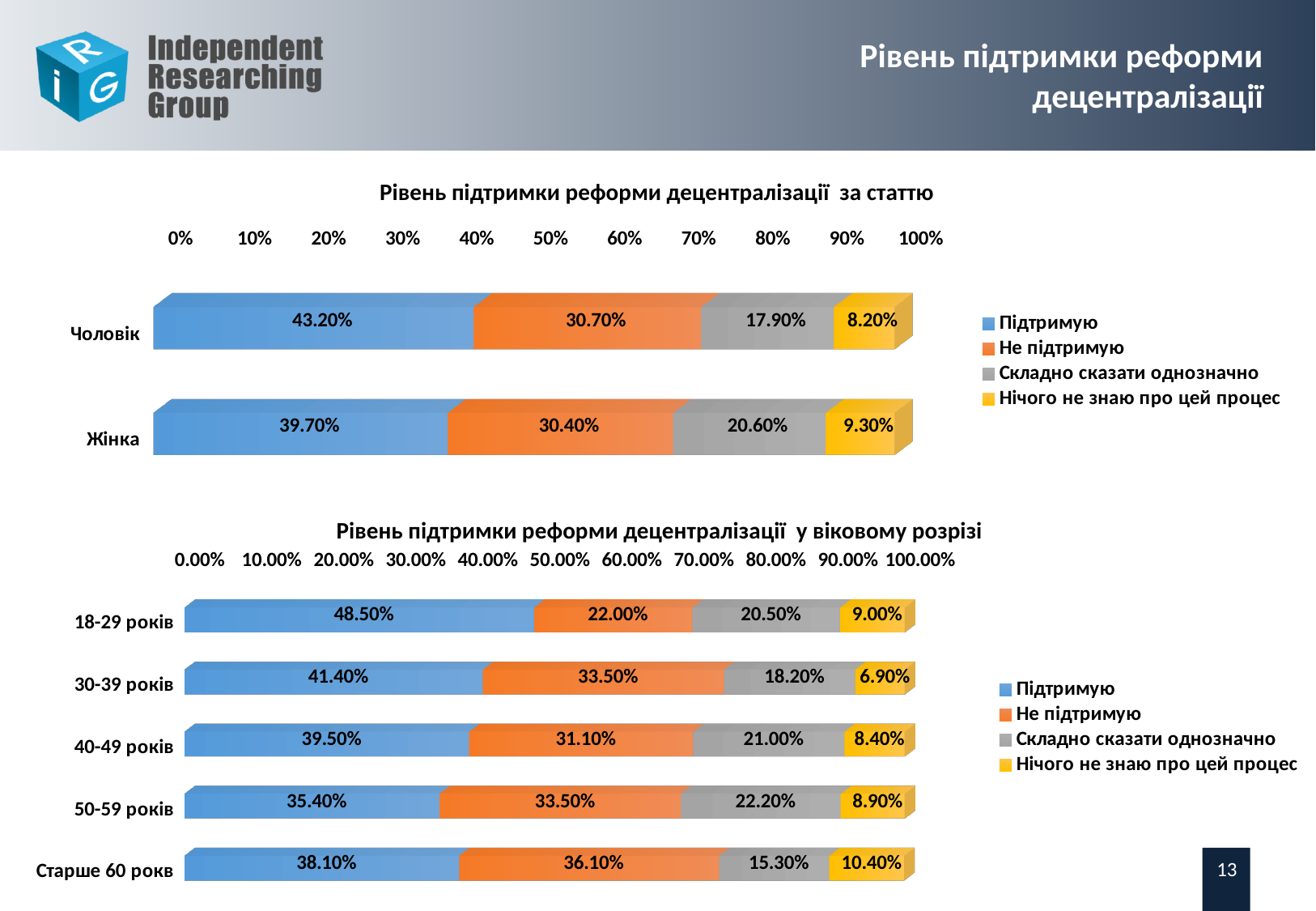
In the chart 'Рівень підтримки реформи децентралізації за статтю', what is the value of 'Нічого не знаю про цей процес' for 'Жінка'? 9.30% In the chart 'Рівень підтримки реформи децентралізації у віковому розрізі', which age group has the lowest 'Підтримую' value? 50-59 років In the chart 'Рівень підтримки реформи децентралізації у віковому розрізі', how many age groups are shown? 5 In the chart 'Рівень підтримки реформи децентралізації у віковому розрізі', what is the value of 'Не підтримую' for 'Старше 60 років'? 36.10% In the chart 'Рівень підтримки реформи децентралізації у віковому розрізі', which colour represents 'Нічого не знаю про цей процес'? Yellow In the chart 'Рівень підтримки реформи децентралізації за статтю', what kind of chart is it? Stacked bar chart In the chart 'Рівень підтримки реформи децентралізації за статтю', what is the difference between the 'Підтримую' values for 'Чоловік' and 'Жінка'? 3.50% In the chart 'Рівень підтримки реформи децентралізації у віковому розрізі', which age group has the highest 'Підтримую' value? 18-29 років In the chart 'Рівень підтримки реформи децентралізації за статтю', what is the value of 'Підтримую' for 'Чоловік'? 43.20% In the chart 'Рівень підтримки реформи децентралізації у віковому розрізі', what is the difference between 'Не підтримую' for '30-39 років' and '18-29 років'? 11.50% In the chart 'Рівень підтримки реформи децентралізації у віковому розрізі', which is larger: 'Складно сказати однозначно' for '40-49 років' or for '30-39 років'? 40-49 років In the chart 'Рівень підтримки реформи децентралізації за статтю', how many series does the legend list? 4